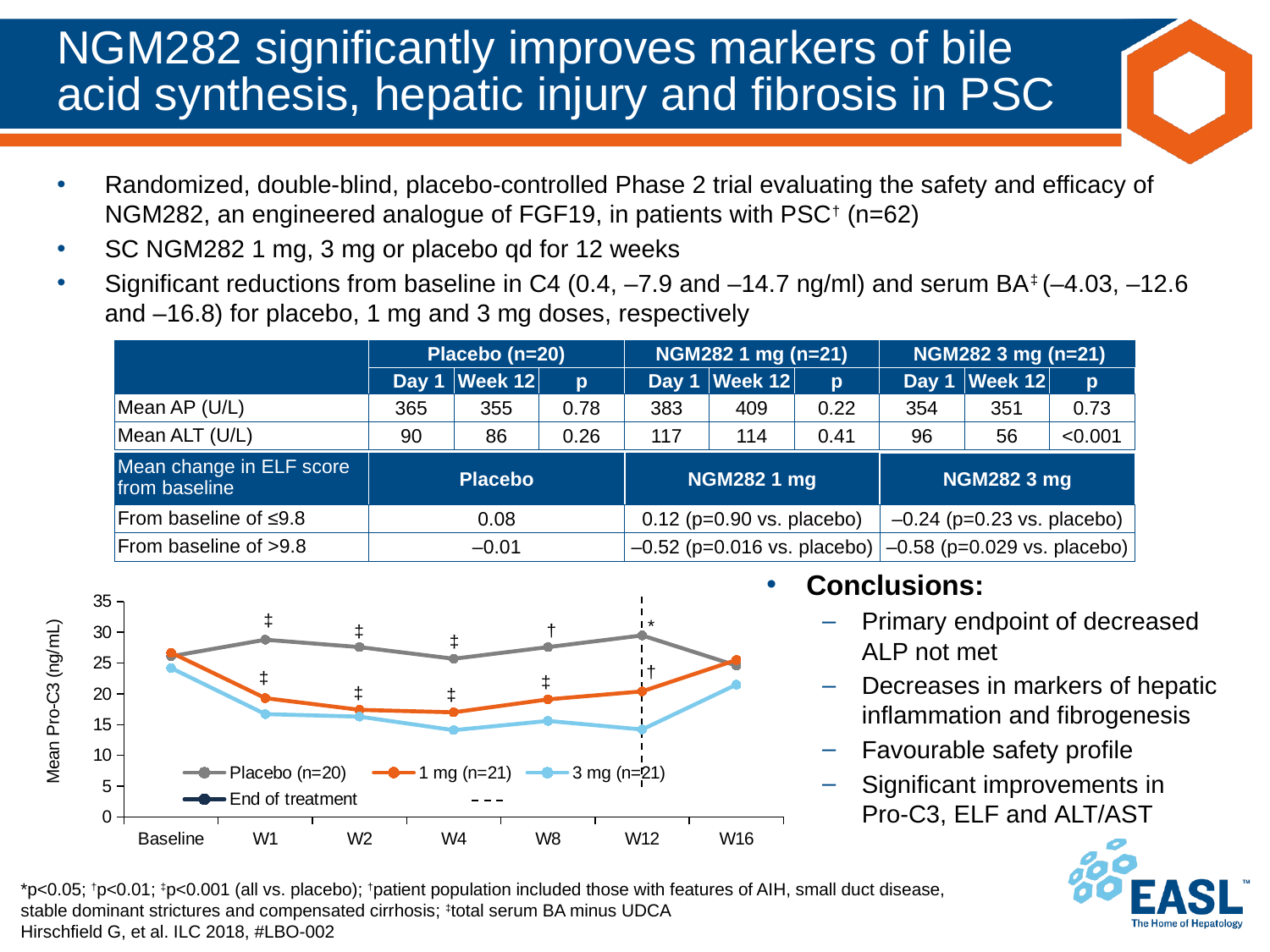
In the Mean Pro-C3 chart, is the value for 1 mg (n=21) at W2 greater or less than 20? less In the Mean Pro-C3 chart, does the 3 mg (n=21) line rise or fall from Baseline to W1? fall In the Mean Pro-C3 chart, is the value for Placebo (n=20) at W12 greater or less than 25? greater What kind of chart is shown on the slide? Line chart In the Mean Pro-C3 chart, which group has the lowest value at W12? 3 mg (n=21) In the Mean Pro-C3 chart, is the value for 3 mg (n=21) at W12 greater or less than 20? less In the Mean Pro-C3 chart, which group has the higher value at W16: 1 mg (n=21) or 3 mg (n=21)? 1 mg (n=21) How many time points are plotted along the x axis of the Mean Pro-C3 chart? 7 How many treatment groups are plotted as lines in the Mean Pro-C3 chart? 3 What is the label on the y axis of the line chart? Mean Pro-C3 (ng/mL) In the Mean Pro-C3 chart, which group has the highest value at W8? Placebo (n=20) In the Mean Pro-C3 chart, which group has the higher value at W1: Placebo (n=20) or 3 mg (n=21)? Placebo (n=20)